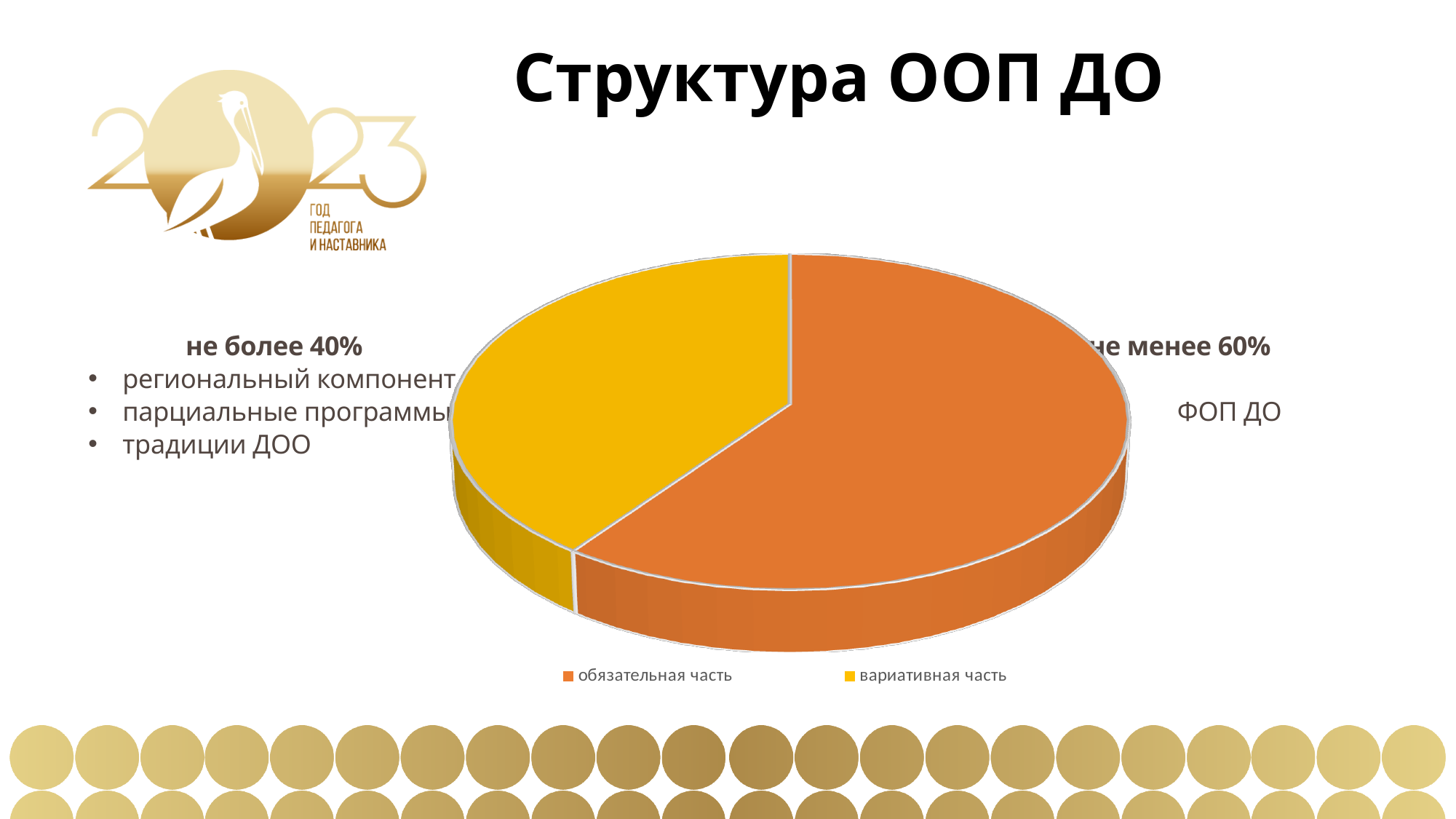
What kind of chart is shown on the slide? pie chart What colour is the обязательная часть slice in the pie chart? orange Which slice is larger, обязательная часть or вариативная часть? обязательная часть Which slice of the pie chart is the smallest? вариативная часть How many slices does the pie chart have? 2 Which slice of the pie chart is the largest? обязательная часть What are the two legend entries of the pie chart? обязательная часть, вариативная часть How many entries does the legend of the pie chart list? 2 Does the обязательная часть slice take up more or less than half of the pie? more